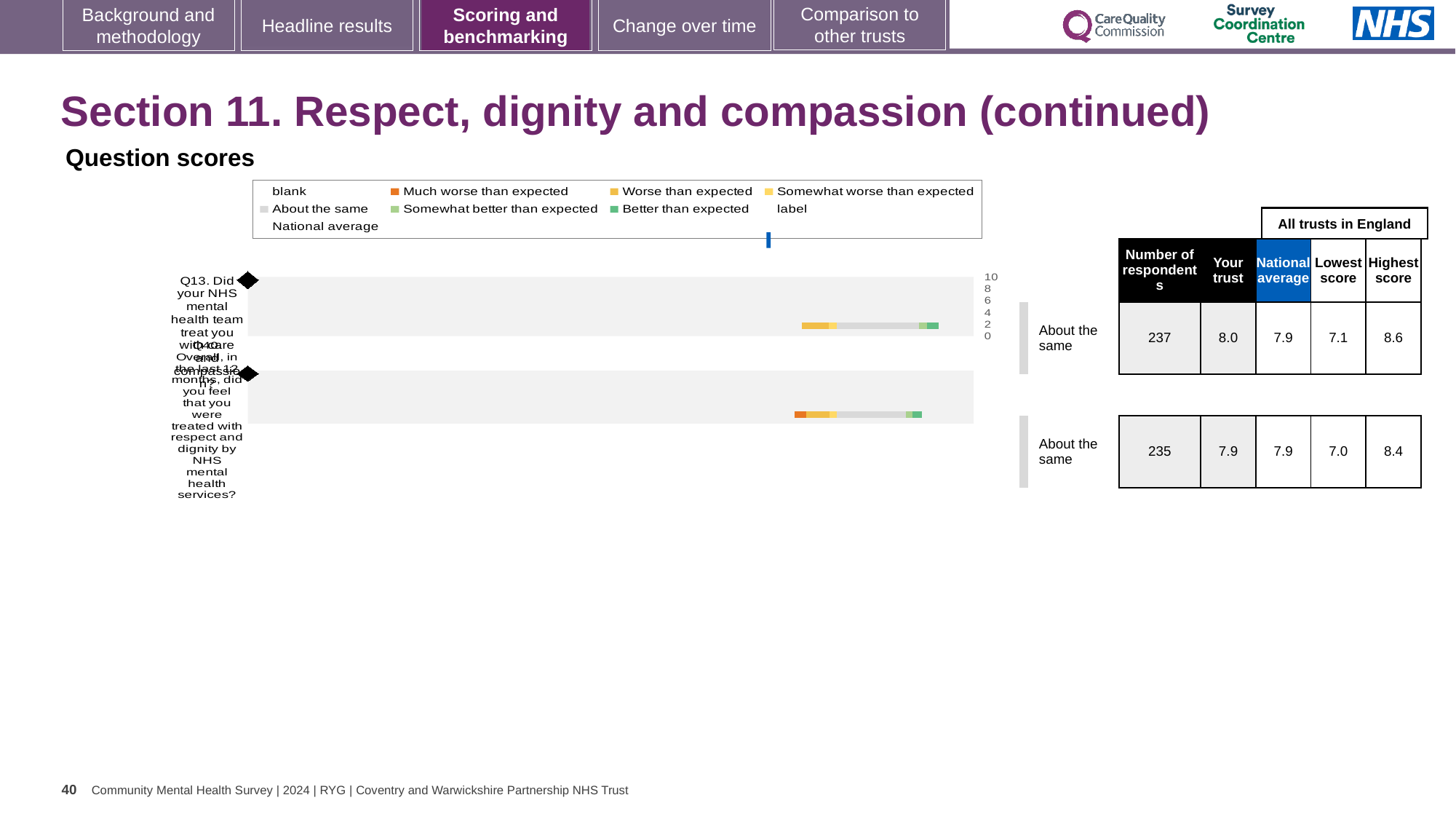
What is the number of respondents for Q13? 237 In the chart legend, what does the blue marker represent? National average What kind of chart is used to show the question scores on this slide? bar chart What benchmark category is shown next to the Q13 bar? About the same What is the 'Your trust' score for Q13? 8.0 In the chart legend, which colour represents 'Much worse than expected'? orange How many questions are plotted in the question scores chart? 2 What is the lowest score across all trusts in England for Q40? 7.0 What is the national average score for Q40? 7.9 Which question has the higher 'Your trust' score, Q13 or Q40? Q13 Which question has the higher 'Highest score' value? Q13 What is the difference between the highest score and the lowest score for Q13? 1.5